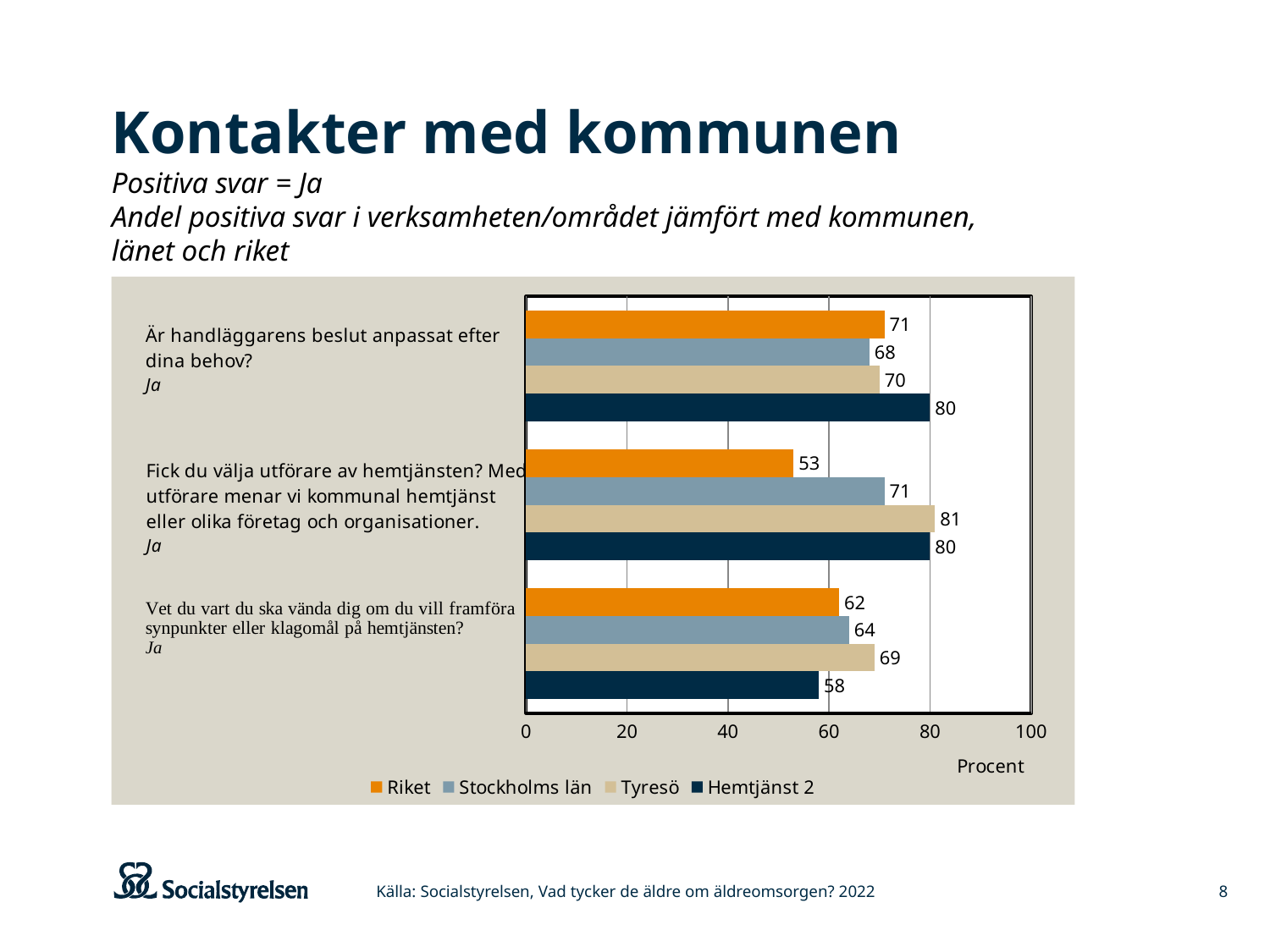
What is the value for Hemtjänst 2 for the question "Är handläggarens beslut anpassat efter dina behov?"? 80 What kind of chart is shown on the slide? bar chart What unit is shown on the x axis of the chart? Procent How many series does the legend list? 4 Which series has the lowest value for the question "Vet du vart du ska vända dig om du vill framföra synpunkter eller klagomål på hemtjänsten?"? Hemtjänst 2 How many questions (categories) are shown in the chart? 3 Which series has the highest value for the question "Fick du välja utförare av hemtjänsten?"? Tyresö What is the difference between Hemtjänst 2 and Stockholms län for the question "Är handläggarens beslut anpassat efter dina behov?"? 12 Is the value for Riket for the question "Fick du välja utförare av hemtjänsten?" greater or less than 60? less What is the value for Tyresö for the question "Vet du vart du ska vända dig om du vill framföra synpunkter eller klagomål på hemtjänsten?"? 69 For the question "Fick du välja utförare av hemtjänsten?", which is larger: Riket or Stockholms län? Stockholms län What is the value for Riket for the question "Fick du välja utförare av hemtjänsten?"? 53